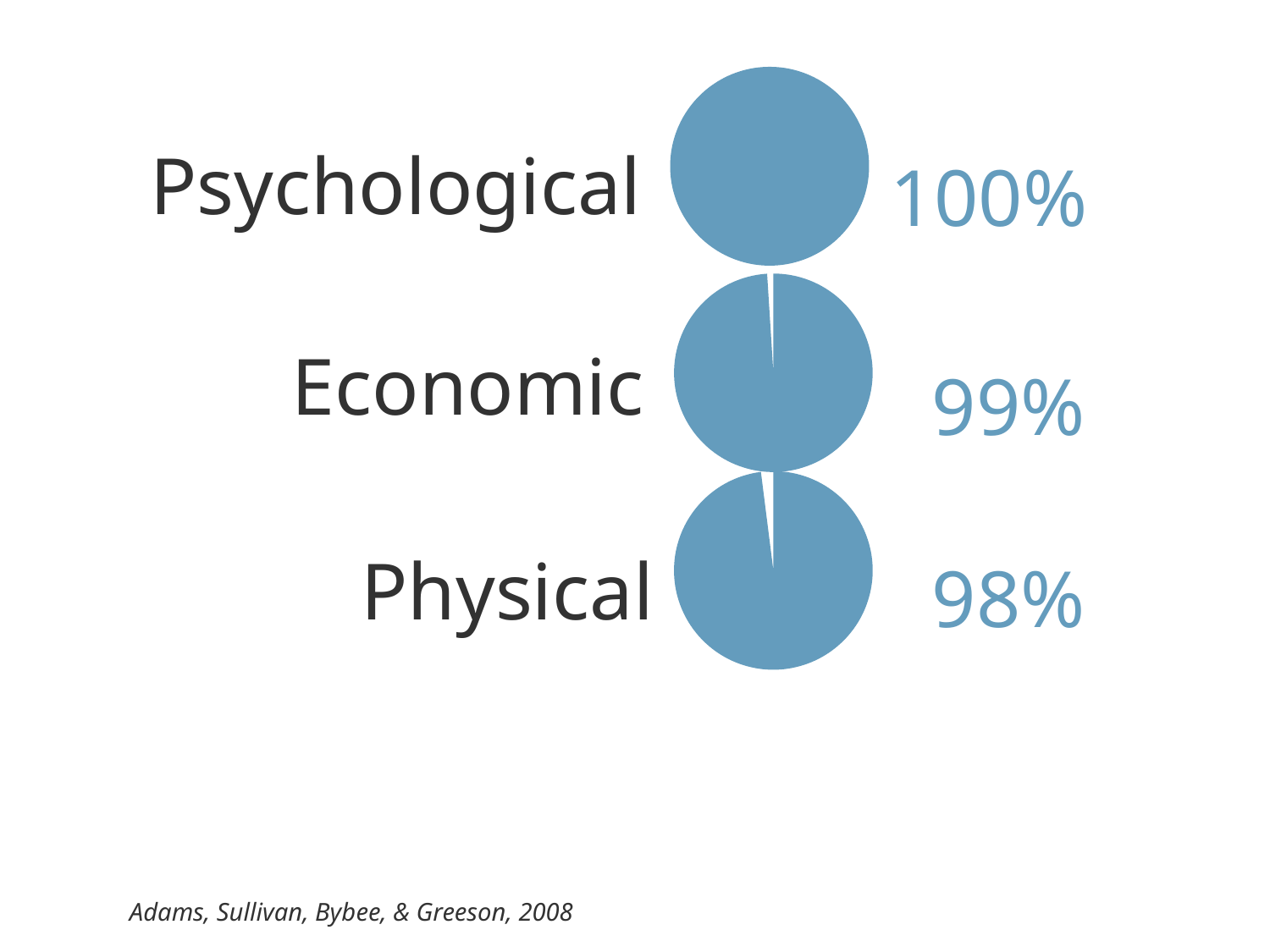
How many categories are shown on the slide? 3 What is the difference between the Psychological value and the Physical value? 2% What is the difference between the Economic value and the Physical value? 1% What value is shown for Economic? 99% Do the values rise or fall going from the top chart to the bottom chart? Fall Which is larger, the value for Economic or the value for Physical? Economic Which category has the lowest value? Physical Which category has the highest value? Psychological What kind of chart is used for each category on the slide? Pie chart What value is shown for Physical? 98% What value is shown for Psychological? 100% What source citation is shown at the bottom of the slide? Adams, Sullivan, Bybee, & Greeson, 2008